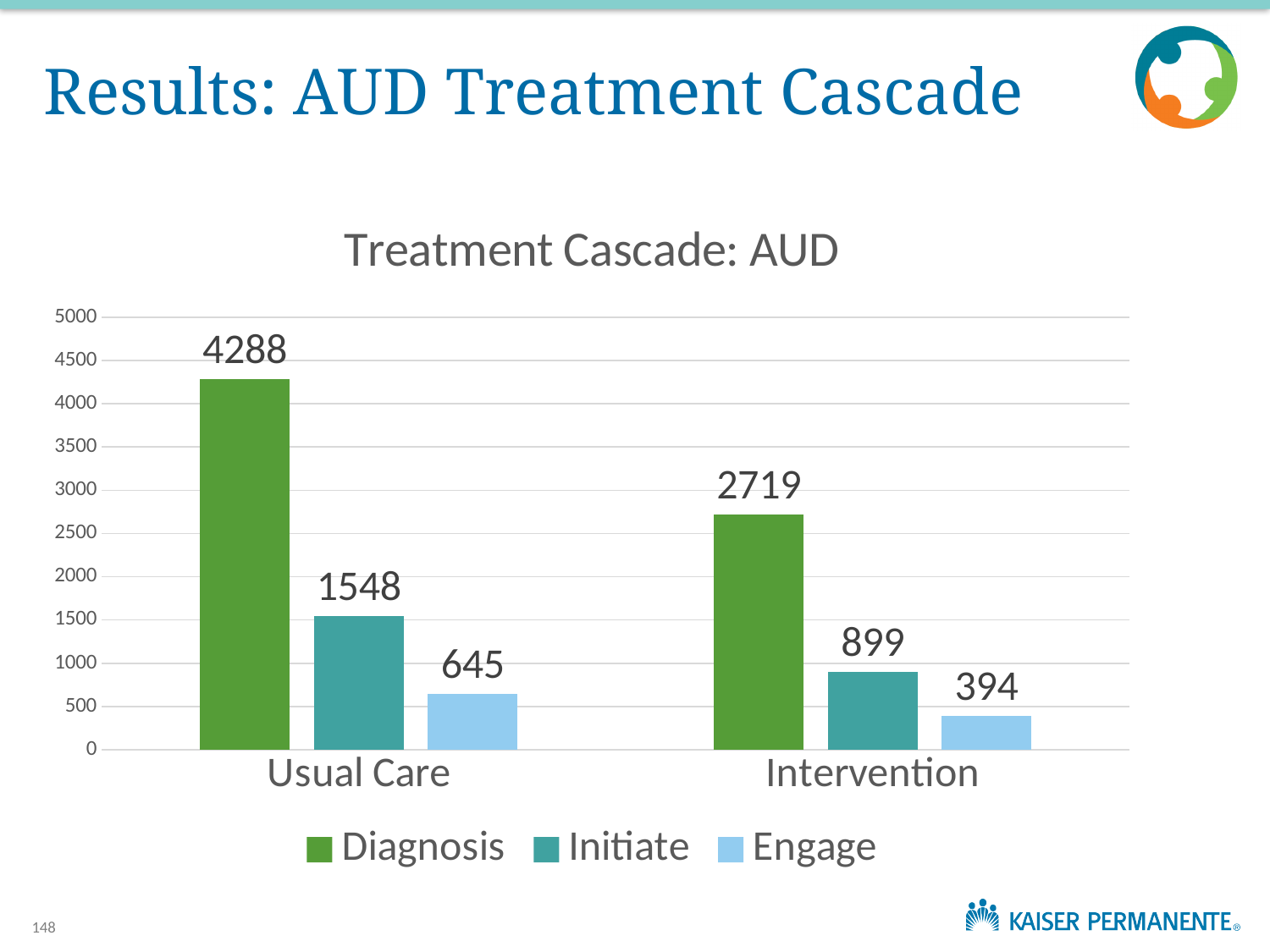
Which series has the highest value for Intervention? Diagnosis What is the Engage value for Usual Care? 645 What kind of chart is shown on the slide? Bar chart What is the Diagnosis value for Usual Care? 4288 How many categories are shown on the x axis? 2 How many series does the legend list? 3 What is the difference between the Diagnosis values for Usual Care and Intervention? 1569 Which is larger, the Engage value for Usual Care or the Engage value for Intervention? Usual Care Which series has the lowest value for Usual Care? Engage What is the difference between the Initiate and Engage values for Intervention? 505 What is the Initiate value for Intervention? 899 What is the title of the chart? Treatment Cascade: AUD